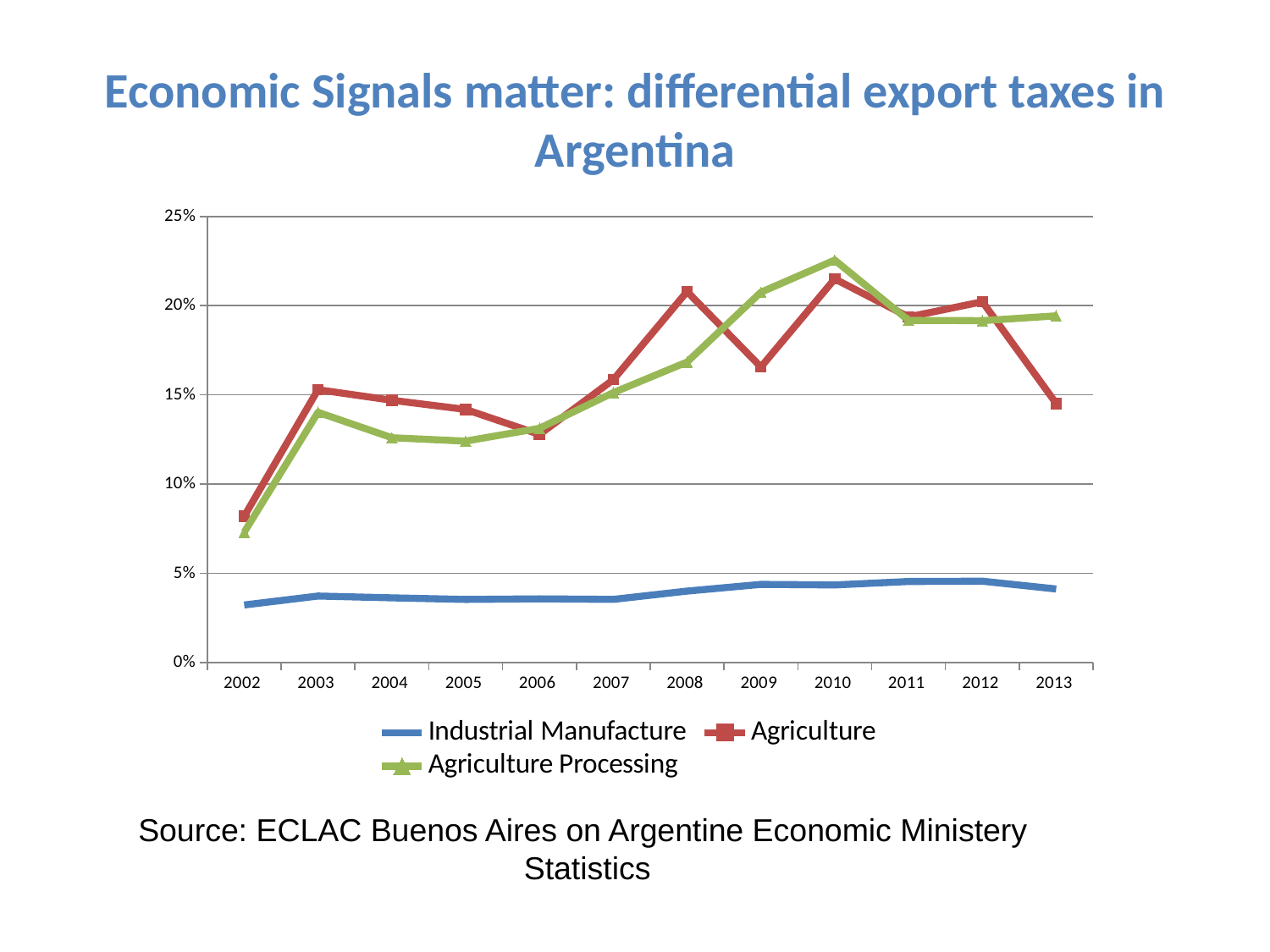
How many series does the legend list? 3 In which year does the Agriculture Processing series reach its highest value? 2010 Which series has the lowest values across all years? Industrial Manufacture Is the value for Agriculture in 2009 greater or less than 20%? less Is the value for Industrial Manufacture in 2002 greater or less than 5%? less What kind of chart is shown on the slide? line chart In 2008, which is higher: Agriculture or Agriculture Processing? Agriculture How many years are plotted along the x axis? 12 What colour is the Agriculture line in the chart? red Does the Agriculture series rise or fall between 2012 and 2013? fall In which year is the Agriculture series at its lowest value? 2002 Is the value for Agriculture Processing in 2010 greater or less than 20%? greater